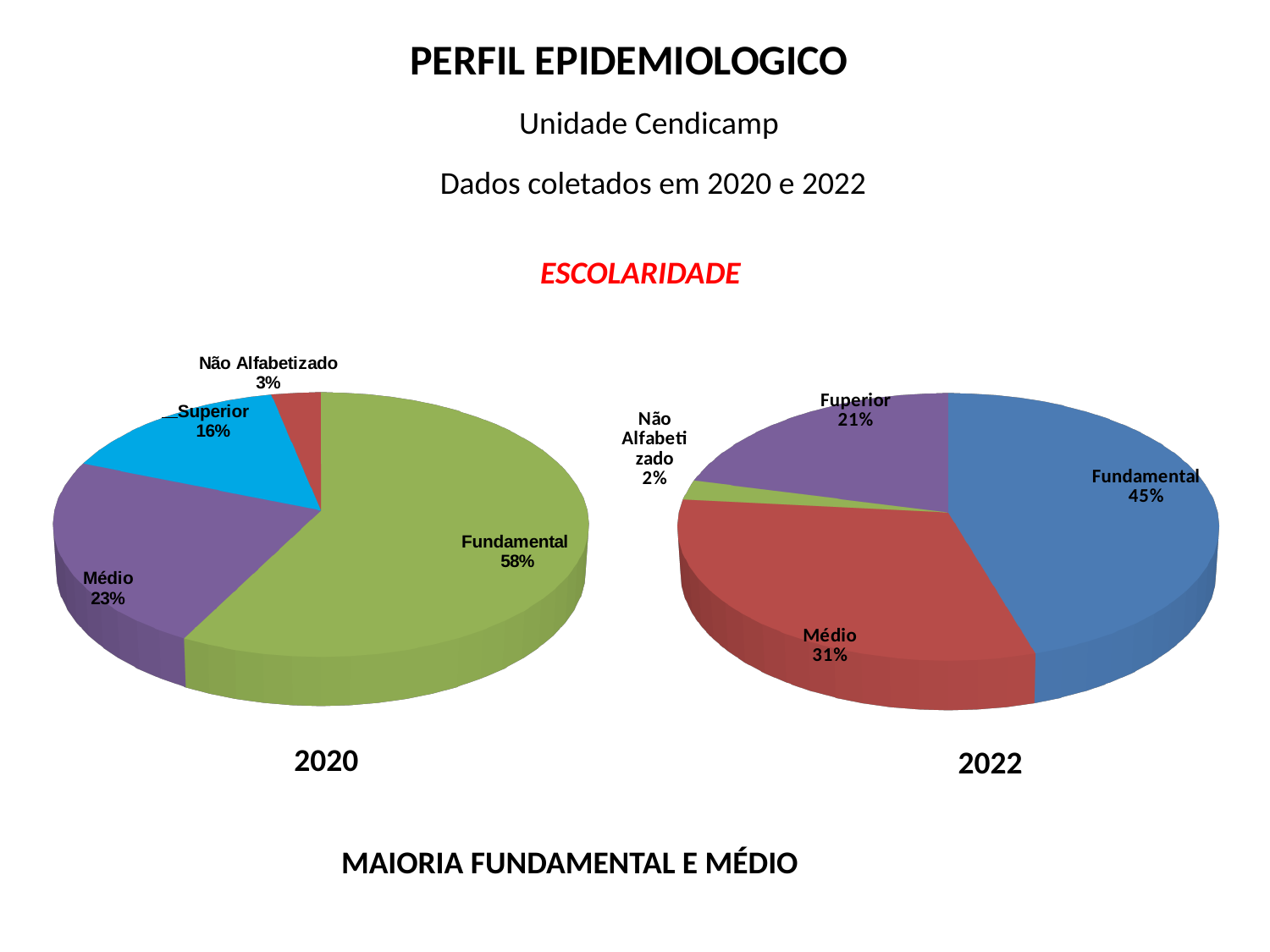
In the 2022 pie chart, what share does Médio have? 31% In the 2020 pie chart, which category has the smallest share? Não Alfabetizado In the 2020 pie chart, which is larger: Médio or Superior? Médio In the 2020 pie chart, what is the combined share of Fundamental and Médio? 81% What is the difference between the Fundamental share in 2020 and the Fundamental share in 2022? 13 percentage points In the 2022 pie chart, which category has the largest share? Fundamental In the 2020 pie chart, what share does Superior have? 16% In the 2022 pie chart, what share does Não Alfabetizado have? 2% In the 2020 pie chart, what share does Fundamental have? 58% What colour is the Fundamental slice in the 2022 pie chart? Blue How many slices does the 2022 pie chart have? 4 What type of chart is used for the 2020 data? Pie chart